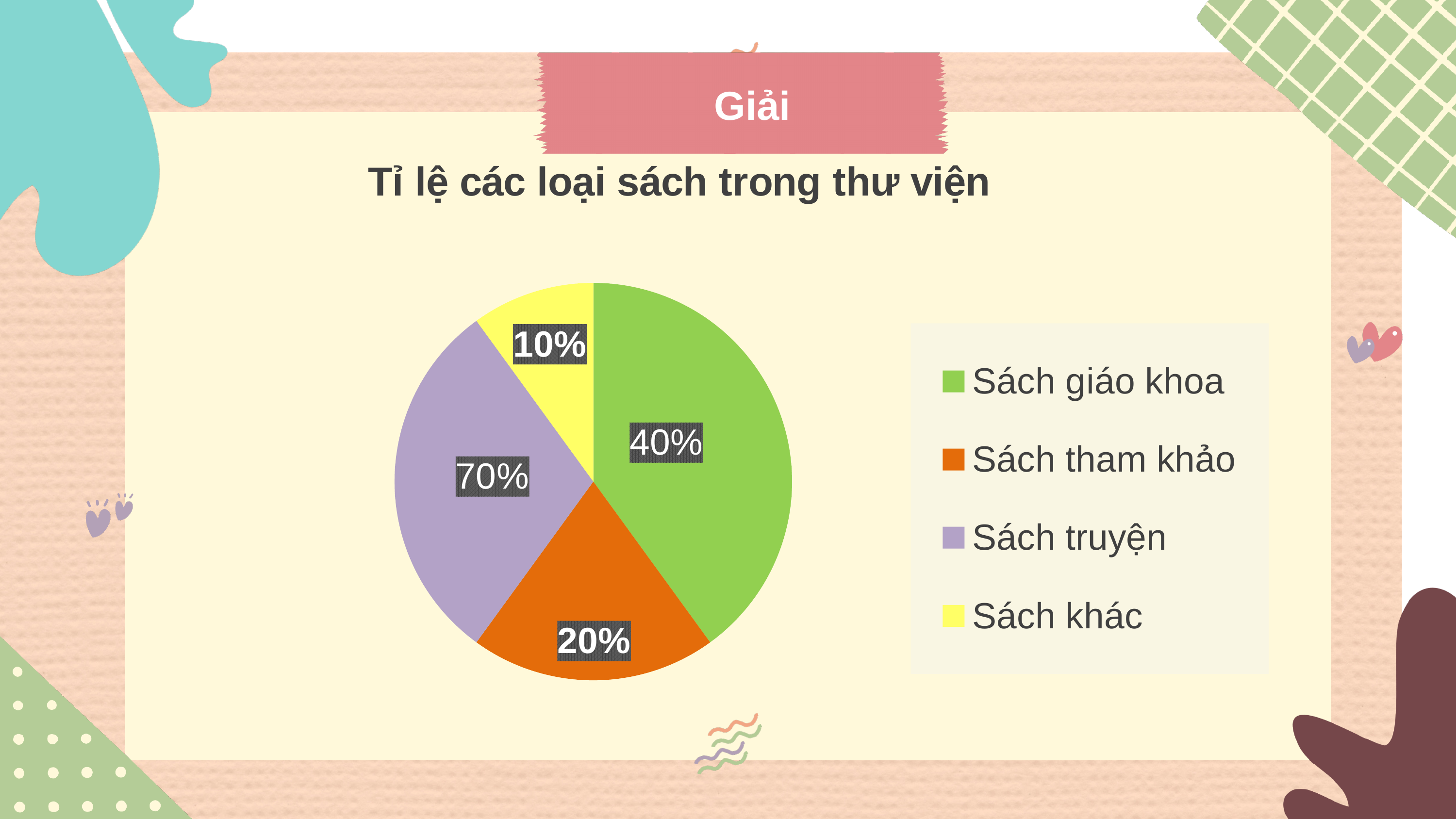
What is the title of the chart? Tỉ lệ các loại sách trong thư viện Which is larger, the slice for Sách tham khảo or the slice for Sách khác? Sách tham khảo Which category has the smallest slice of the pie? Sách khác How many categories does the pie chart show? 4 What percentage of the pie is Sách giáo khoa? 40% What percentage of the pie is Sách khác? 10% What is the difference in percentage points between Sách tham khảo and Sách khác? 10% What kind of chart is shown on the slide? pie chart What percentage of the pie is Sách tham khảo? 20% Which is larger, the slice for Sách giáo khoa or the slice for Sách tham khảo? Sách giáo khoa What is the difference in percentage points between Sách giáo khoa and Sách tham khảo? 20% What colour is the slice for Sách truyện? purple